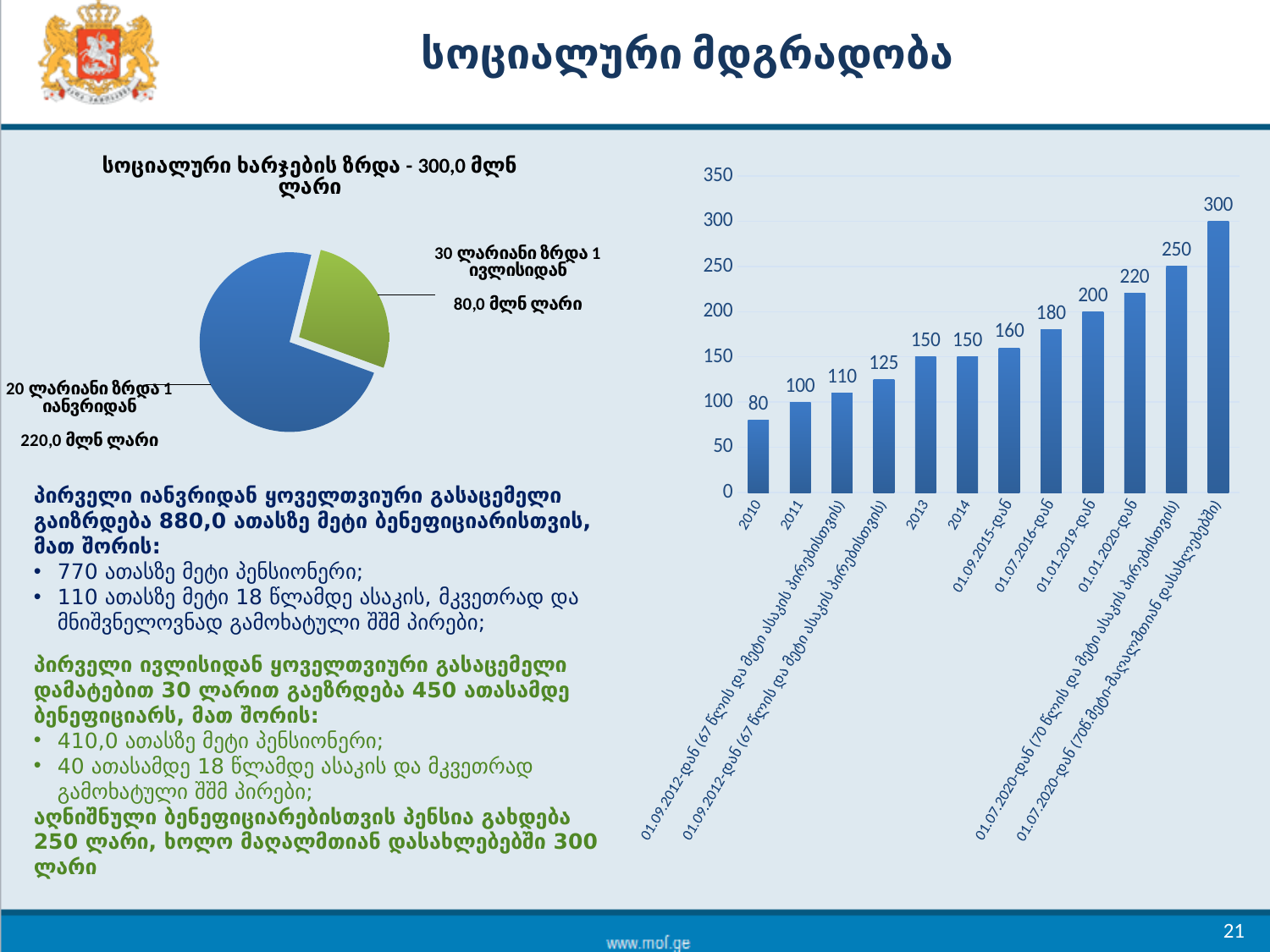
Do the values in the bar chart on the right rise or fall from left to right? rise In the bar chart on the right, what is the value for 01.01.2020-დან? 220 In the bar chart on the right, what is the value for 01.07.2016-დან? 180 In the bar chart on the right, which category has the highest value? 01.07.2020-დან (70წ.მეტი-მაღალმთიან დასახლებებში) In the pie chart on the left, which slice is larger: 20 ლარიანი ზრდა 1 იანვრიდან or 30 ლარიანი ზრდა 1 ივლისიდან? 20 ლარიანი ზრდა 1 იანვრიდან In the pie chart on the left, what is the value of the slice labelled 30 ლარიანი ზრდა 1 ივლისიდან? 80,0 მლნ ლარი In the bar chart on the right, which category has the lowest value? 2010 How many bars are shown in the bar chart on the right? 12 In the bar chart on the right, what is the value for 2010? 80 In the bar chart on the right, what is the difference between the values for 01.01.2019-დან and 01.09.2015-დან? 40 In the bar chart on the right, which is larger: the value for 2013 or the value for 01.07.2016-დან? 01.07.2016-დან In the bar chart on the right, what is the value for 2011? 100